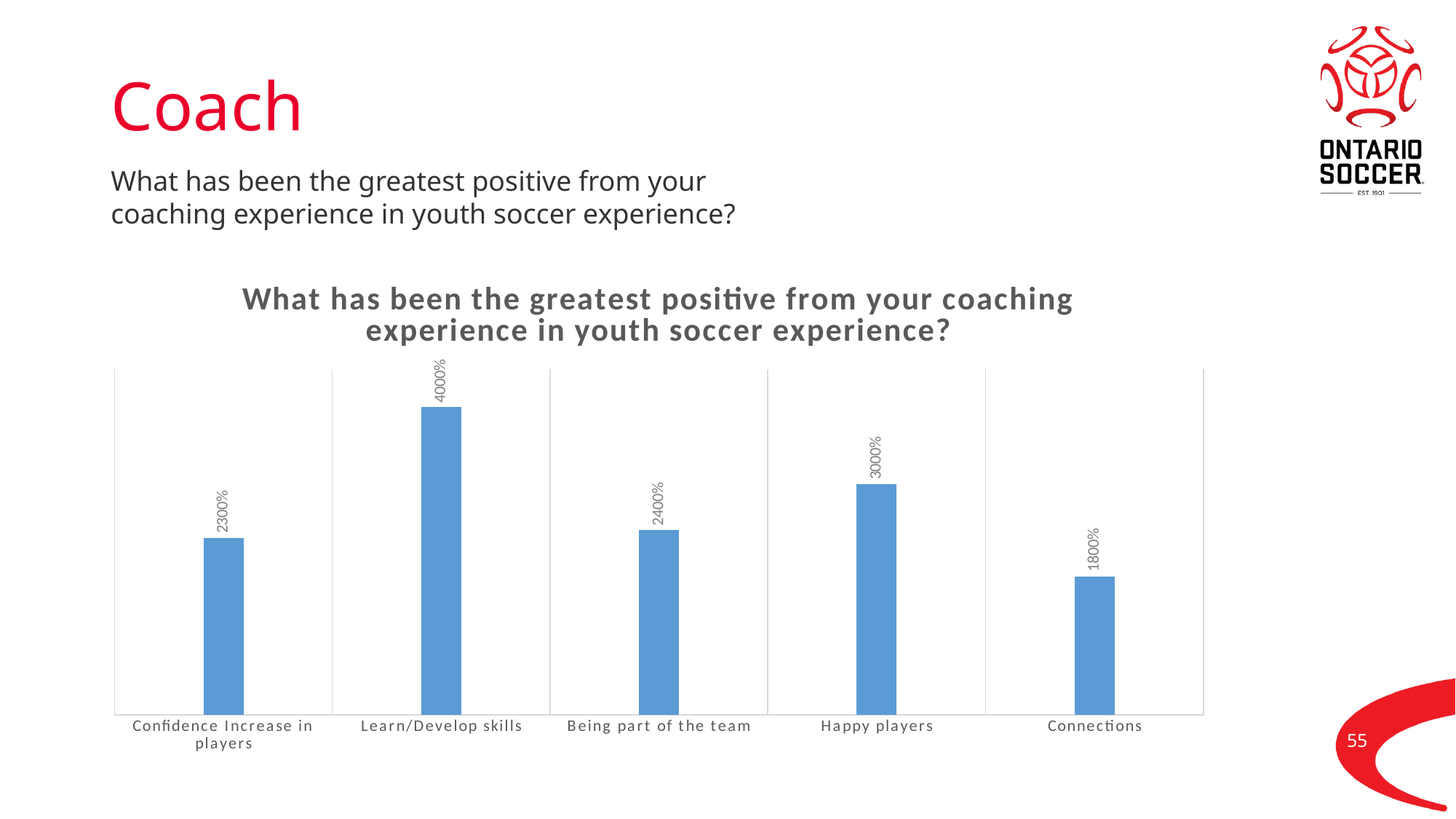
Which is larger, the value for Happy players or the value for Being part of the team? Happy players What is the value for Happy players? 3000% How many categories are shown in the chart? 5 What is the value for Learn/Develop skills? 4000% Which category has the highest value? Learn/Develop skills What is the value for Confidence Increase in players? 2300% What is the difference between the values for Being part of the team and Confidence Increase in players? 100% Which category has the lowest value? Connections What is the value for Connections? 1800% What is the difference between the values for Learn/Develop skills and Happy players? 1000% What is the title of the chart? What has been the greatest positive from your coaching experience in youth soccer experience? What kind of chart is shown on the slide? Bar chart